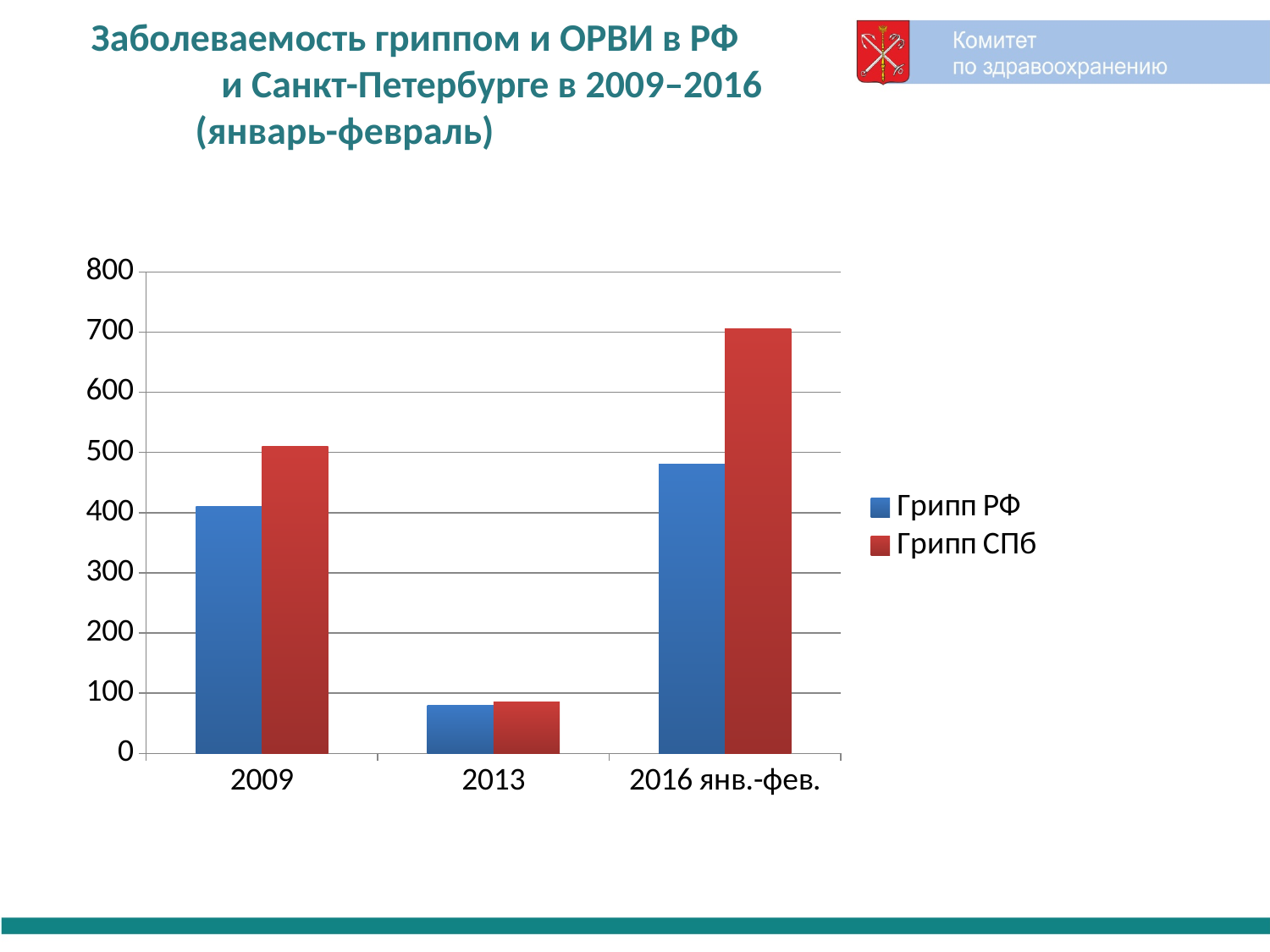
Which category has the lowest value for Грипп РФ? 2013 Is the value for Грипп РФ in 2013 greater or less than 100? less How many series does the legend list? 2 Which is larger in 2016 янв.-фев.: Грипп РФ or Грипп СПб? Грипп СПб What kind of chart is shown on the slide? bar chart Is the value for Грипп СПб in 2016 янв.-фев. greater or less than 600? greater Which is larger: Грипп СПб in 2009 or Грипп СПб in 2016 янв.-фев.? Грипп СПб in 2016 янв.-фев. Is the value for Грипп СПб in 2009 greater or less than 400? greater Which category has the highest value for Грипп СПб? 2016 янв.-фев. What colour are the bars for the Грипп СПб series? red How many categories are shown on the x axis? 3